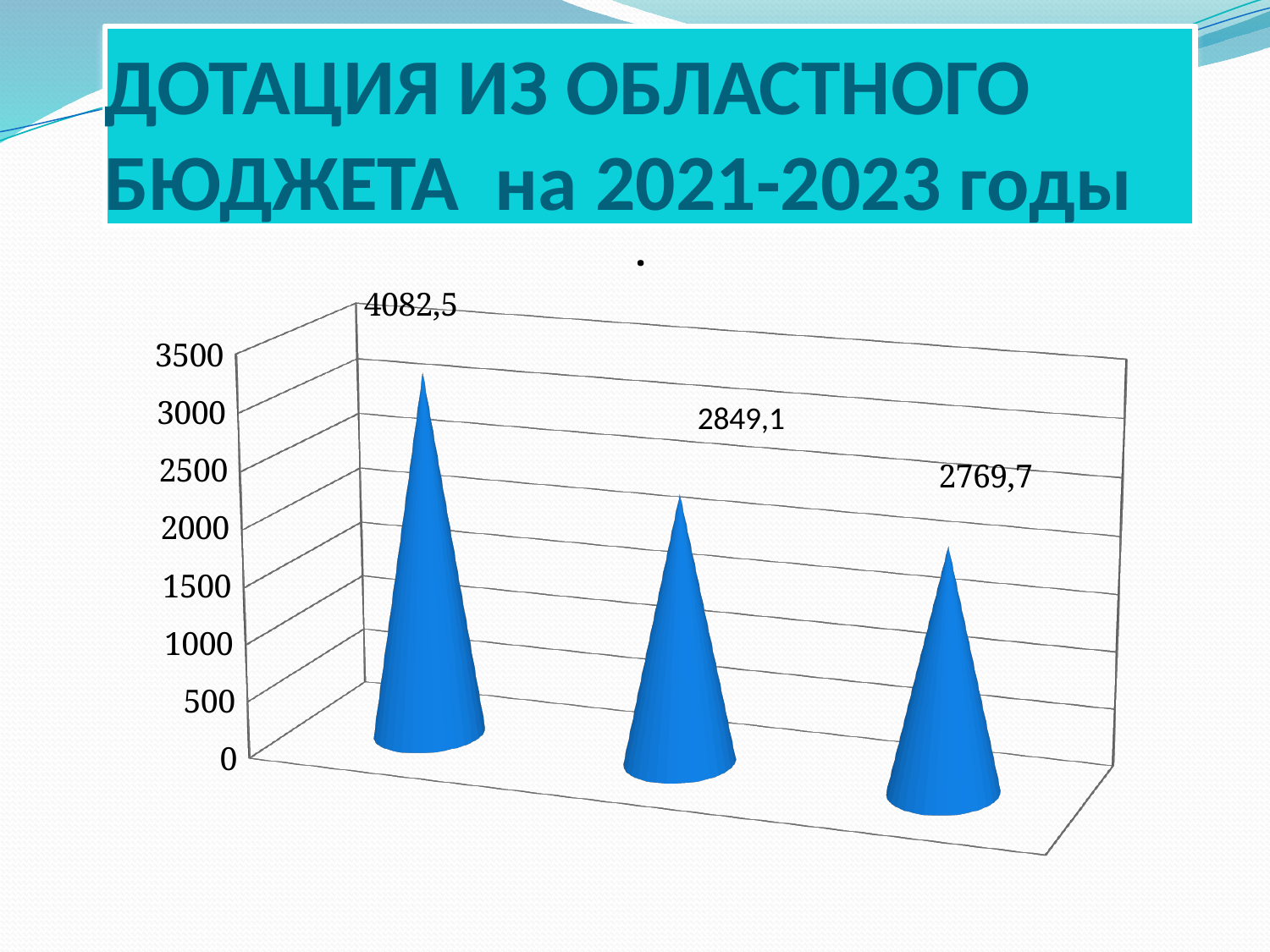
Is the value of the third cone greater or less than 3000? less How many cones (data points) are plotted in the chart? 3 Which cone has the highest value: the first, second or third? the first Which is larger, the value of the first cone or the value of the third cone? the first cone What is the data label on the middle cone in the chart? 2849,1 What is the data label on the first (leftmost) cone in the chart? 4082,5 Do the values rise or fall from left to right across the chart? fall What is the title of the slide containing the chart? ДОТАЦИЯ ИЗ ОБЛАСТНОГО БЮДЖЕТА на 2021-2023 годы Which cone has the lowest value: the first, second or third? the third What is the difference between the second cone's value (2849,1) and the third cone's value (2769,7)? 79,4 What is the data label on the third (rightmost) cone in the chart? 2769,7 What is the difference between the first cone's value (4082,5) and the second cone's value (2849,1)? 1233,4